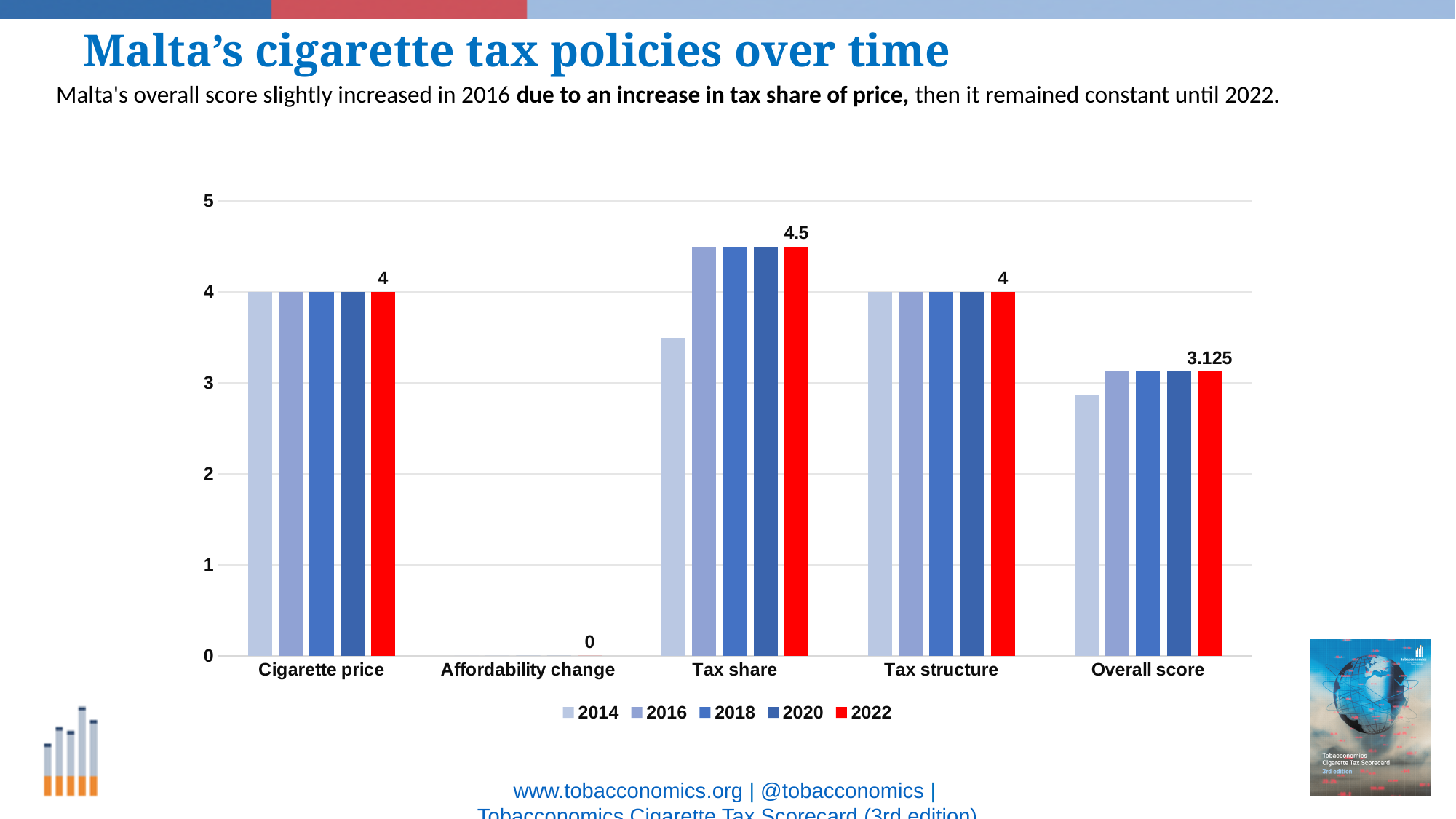
How many categories are shown on the x axis? 5 What is the 2022 value for Affordability change? 0 How many series does the legend list? 5 What kind of chart is shown on the slide? bar chart What is the 2022 value for Tax share? 4.5 Which category has the lowest 2022 value? Affordability change What is the 2022 value for Overall score? 3.125 Which is larger in 2022: Tax share or Tax structure? Tax share What is the difference between the 2022 values for Tax share and Overall score? 1.375 Is the 2014 value for Tax share greater or less than 4? less What is the 2022 value for Cigarette price? 4 Which category has the highest 2022 value? Tax share